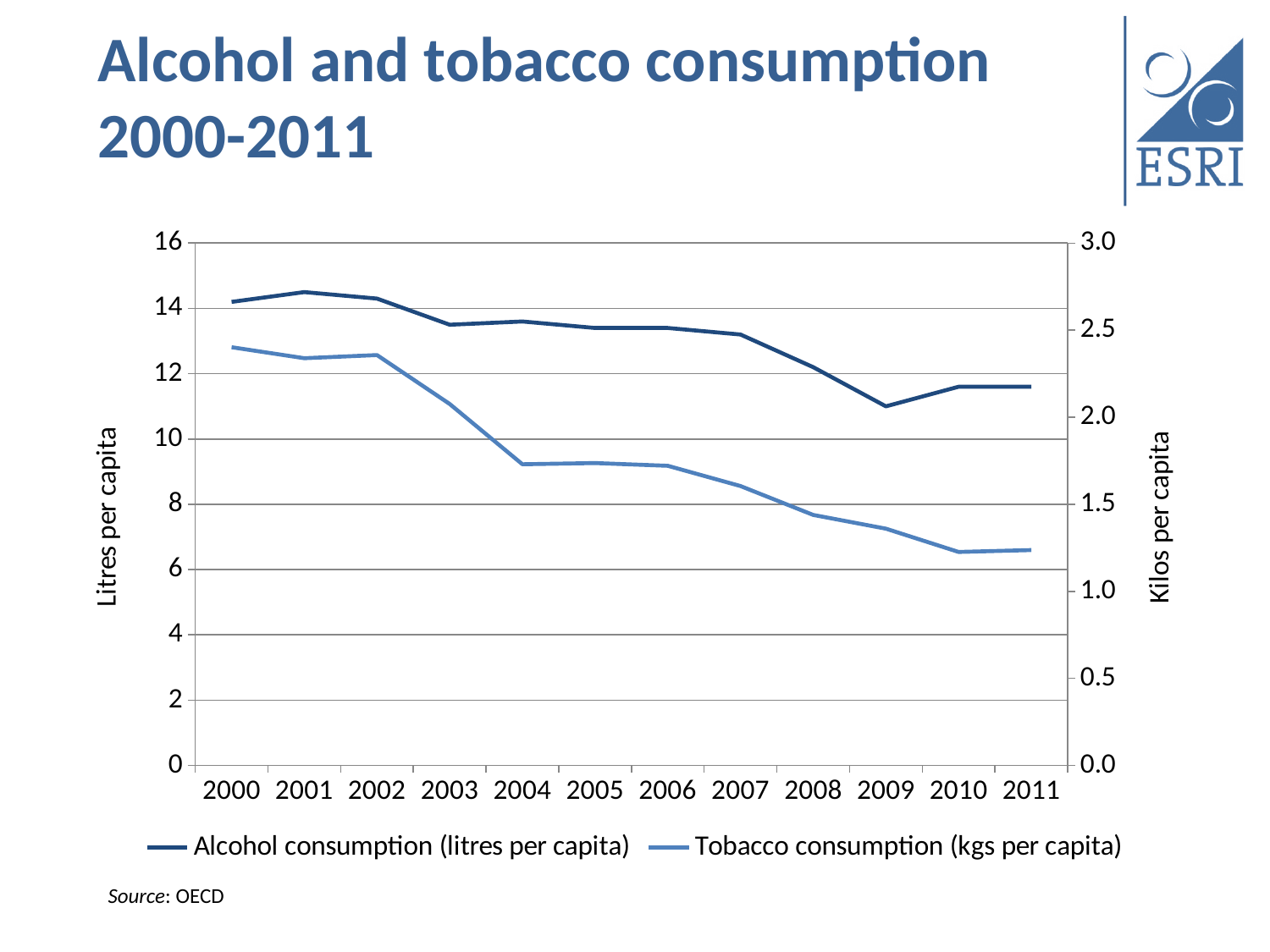
Is the alcohol consumption value for 2009 greater or less than 12 litres per capita? less Which year has higher alcohol consumption, 2003 or 2008? 2003 What kind of chart is shown on the slide? Line chart Overall, does tobacco consumption rise or fall from 2000 to 2011? Fall Overall, does alcohol consumption rise or fall from 2000 to 2011? Fall Is the alcohol consumption value for 2001 greater or less than 14 litres per capita? greater Is the tobacco consumption value for 2000 greater or less than 2.0 kilos per capita? greater What is the label on the right-hand vertical axis? Kilos per capita How many series does the legend list? 2 In which year is alcohol consumption at its lowest? 2009 How many years are plotted along the x axis? 12